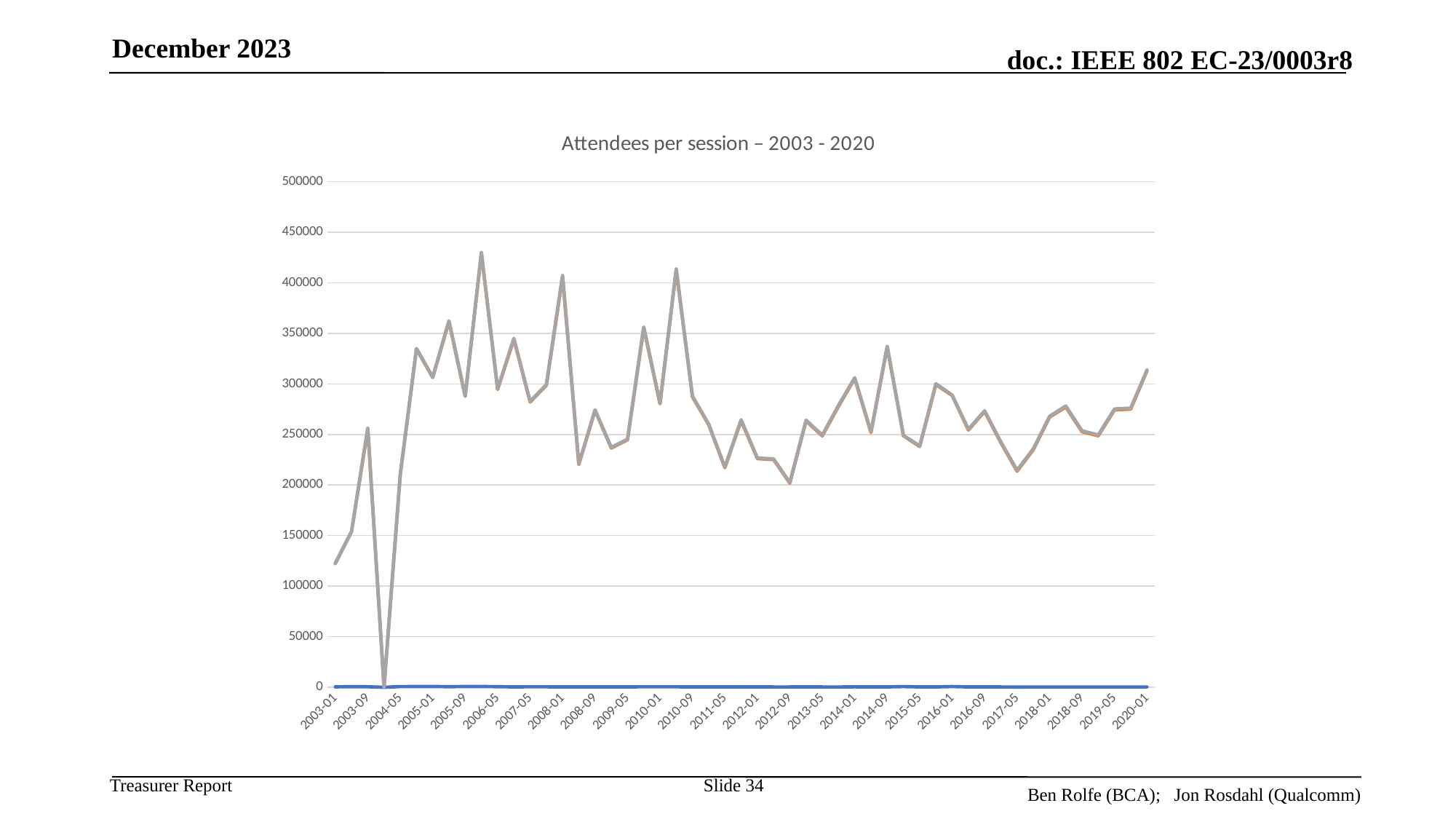
Is the value for 2008-01 greater or less than 350000? greater What is the title of the chart? Attendees per session – 2003 - 2020 Is the value for 2004-05 greater or less than 50000? greater Which is larger, the value for 2003-09 or the value for 2004-05? 2003-09 Do the values rise or fall from 2017-05 to 2020-01? rise Is the value for 2014-09 greater or less than 300000? greater What kind of chart is shown on the slide? line chart What is the highest value shown on the vertical axis? 500000 Which is larger, the value for 2003-01 or the value for 2020-01? 2020-01